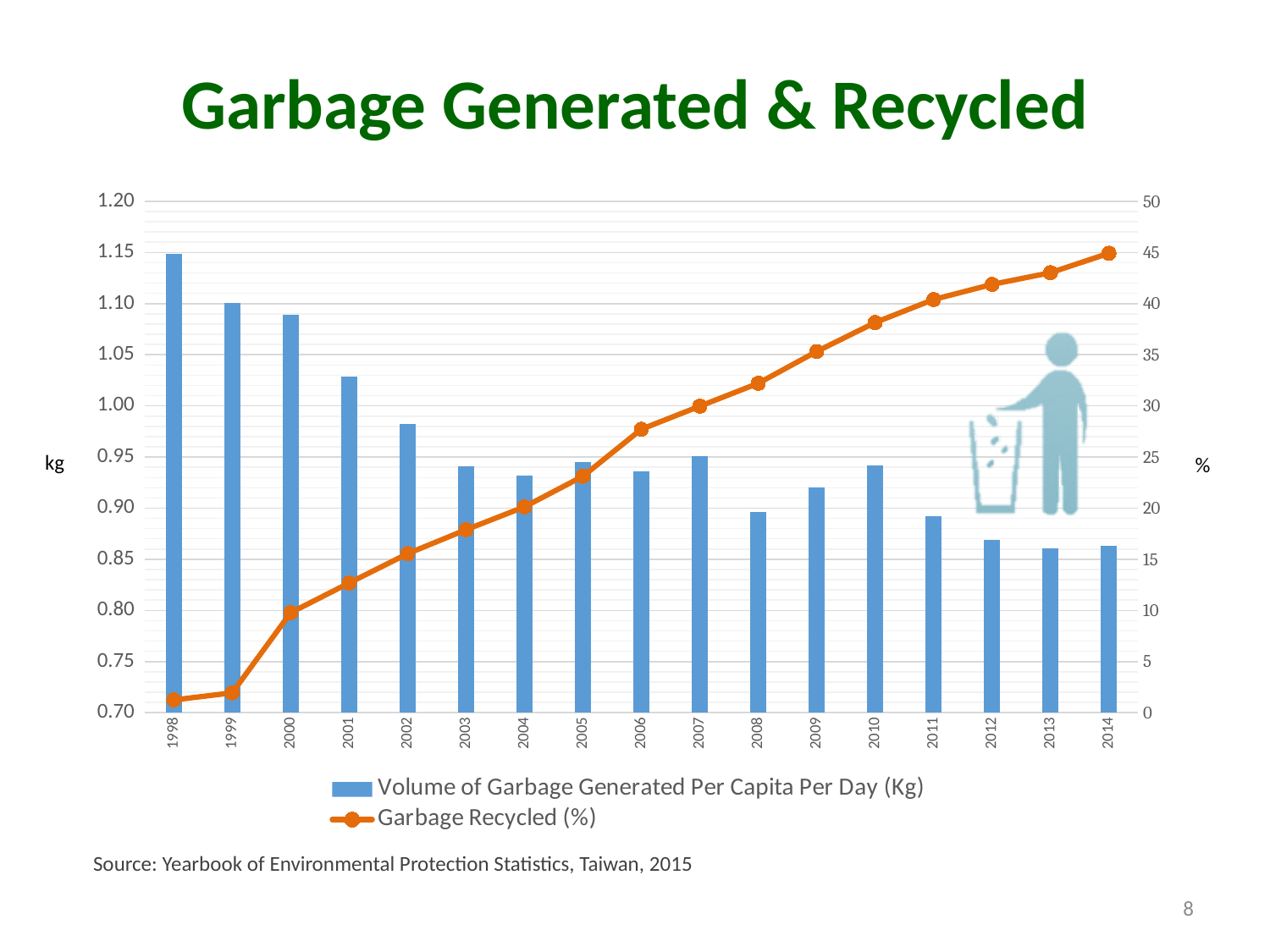
What unit is shown on the left vertical axis of the chart? kg Is the Volume of Garbage Generated Per Capita Per Day for 2012 greater or less than 0.90? less Does the Garbage Recycled (%) line generally rise or fall from 1998 to 2014? rise Which year has the larger Volume of Garbage Generated Per Capita Per Day, 2000 or 2002? 2000 What kind of chart is shown on the slide? A combined bar and line chart Is the Volume of Garbage Generated Per Capita Per Day for 1998 greater or less than 1.10? greater Which year has the highest Garbage Recycled (%)? 2014 Is the Garbage Recycled (%) for 2010 greater or less than 35? greater How many years are shown along the x axis? 17 How many series does the legend list? 2 Which year has the highest Volume of Garbage Generated Per Capita Per Day (Kg)? 1998